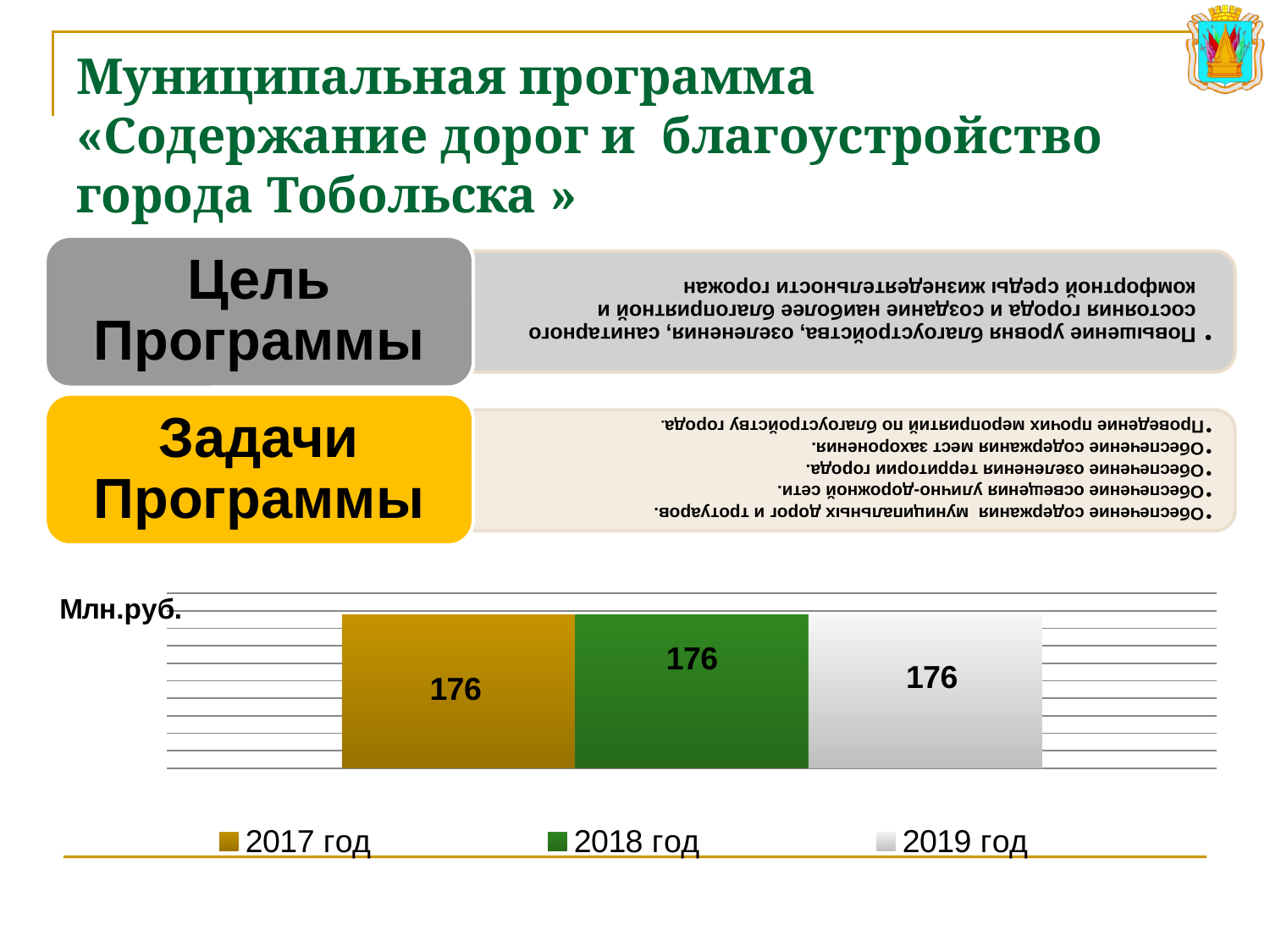
What kind of chart is shown on the slide? Bar chart Do the values change from 2017 год to 2019 год, or stay the same? Stay the same What is the difference between the values for 2017 год and 2019 год? 0 What is the value for 2017 год in the chart? 176 Which colour represents 2018 год in the chart legend? Green What unit is shown for the chart values? Млн.руб. How many series does the chart legend list? 3 How many data labels are printed on the bar? 3 What is the total of the stacked bar across all three years? 528 What is the value for 2019 год in the chart? 176 What is the value for 2018 год in the chart? 176